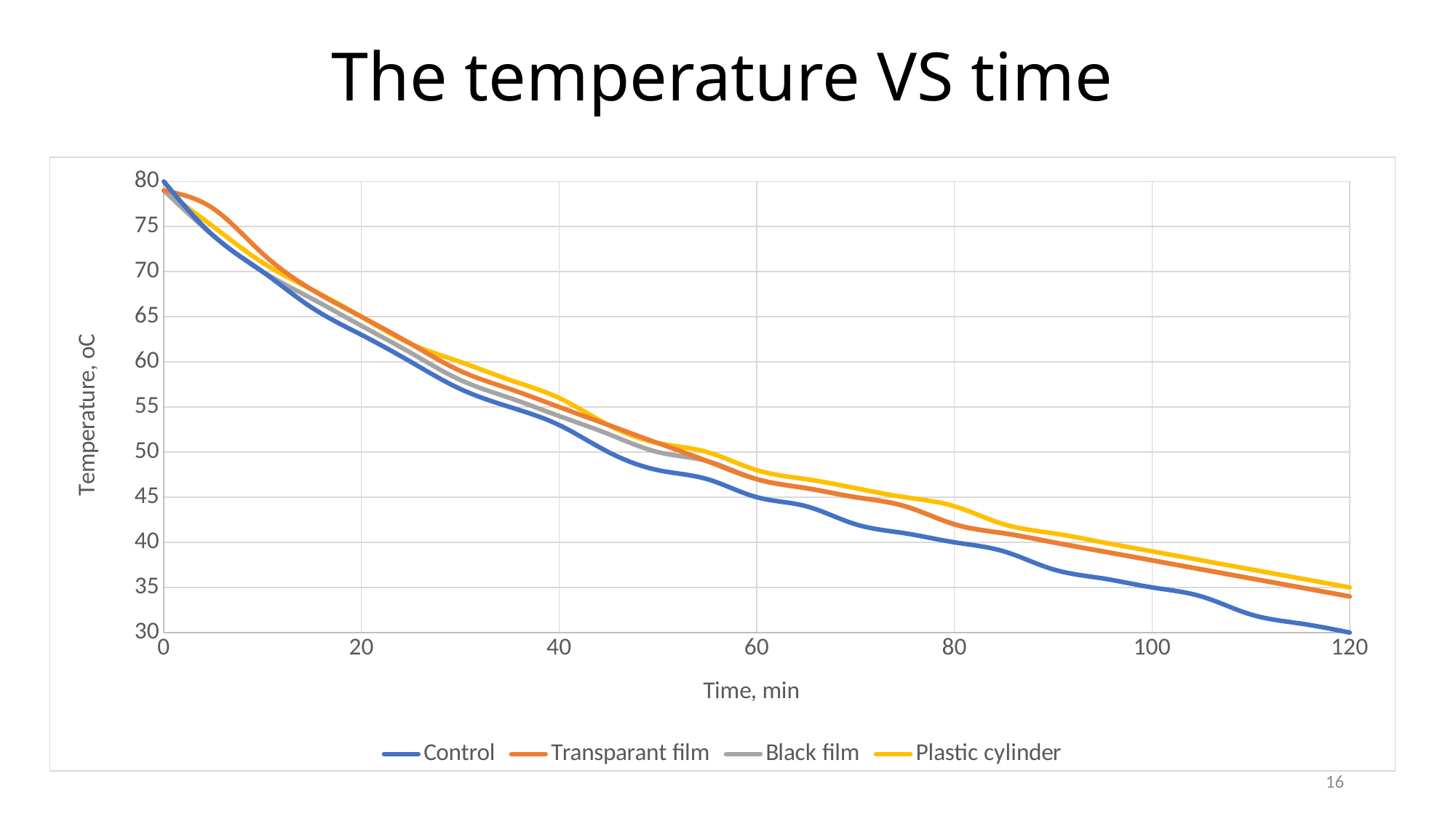
Which series has the lowest temperature at 120 min? Control How many series does the legend list? 4 Do the temperature values rise or fall as time increases along the x axis? fall At 100 min, which is larger: the value for Control or the value for Plastic cylinder? Plastic cylinder What is the title of the x axis? Time, min Is the value for Transparant film at 120 min greater or less than 40? less Is the value for Control at 20 min greater or less than 65? less Is the value for Plastic cylinder at 80 min greater or less than 40? greater What kind of chart is shown on the slide? line chart Which series has the highest temperature at 120 min? Plastic cylinder What is the title of the chart? The temperature VS time